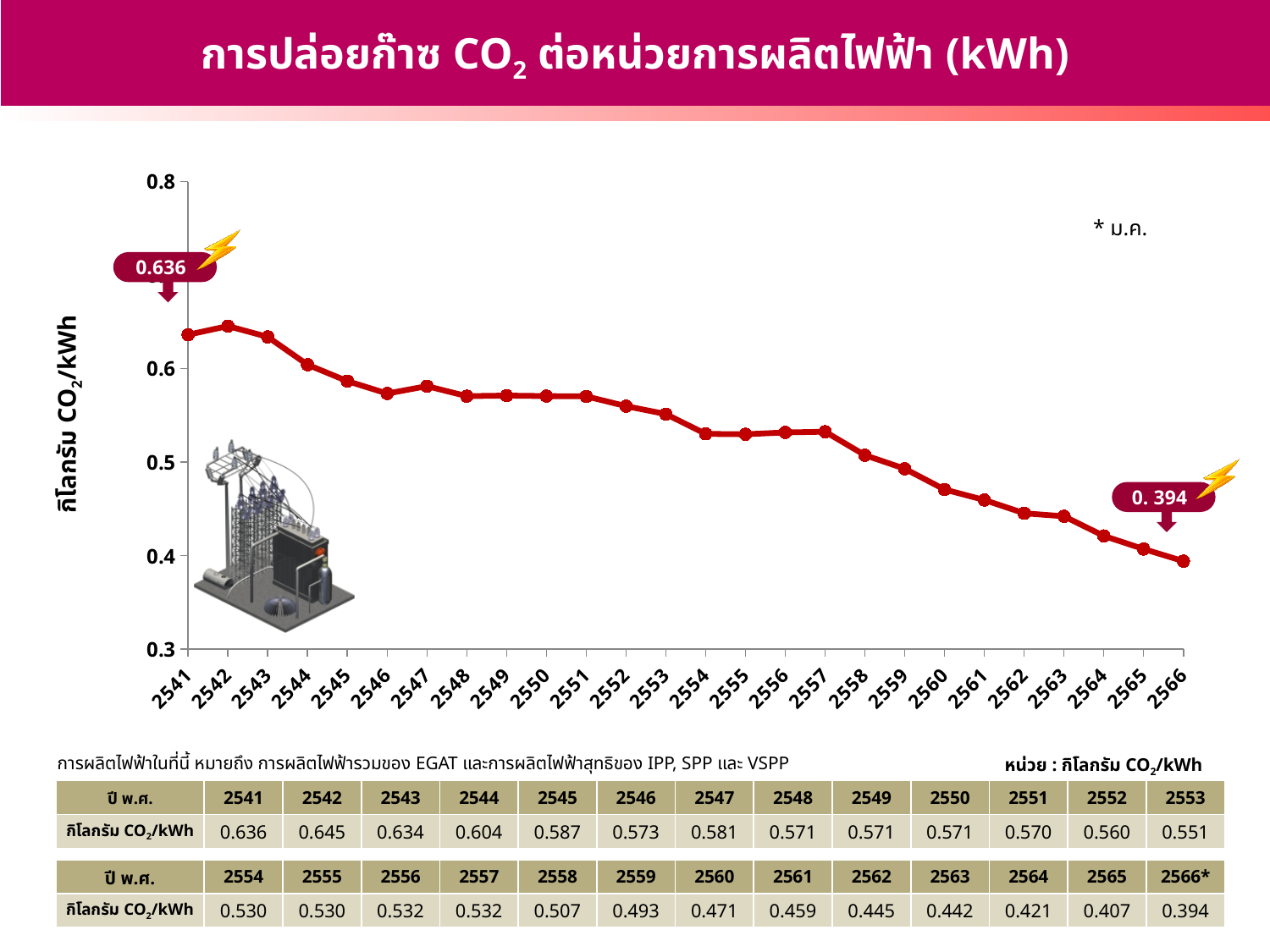
What is the CO2 emission value (kg CO2/kWh) for year 2541? 0.636 Which year has a larger value, 2547 or 2553? 2547 Do the values generally rise or fall from 2541 to 2566? fall What is the difference between the values for 2541 and 2566*? 0.242 What is the CO2 emission value (kg CO2/kWh) for year 2566*? 0.394 Which year has the lowest CO2 emission per kWh? 2566* What kind of chart is shown on the slide? line chart What is the CO2 emission value (kg CO2/kWh) for year 2559? 0.493 Is the value for 2558 greater or less than 0.5? greater How many years are plotted on the x axis? 26 Which year has the highest CO2 emission per kWh? 2542 What is the y-axis label of the chart? กิโลกรัม CO2/kWh